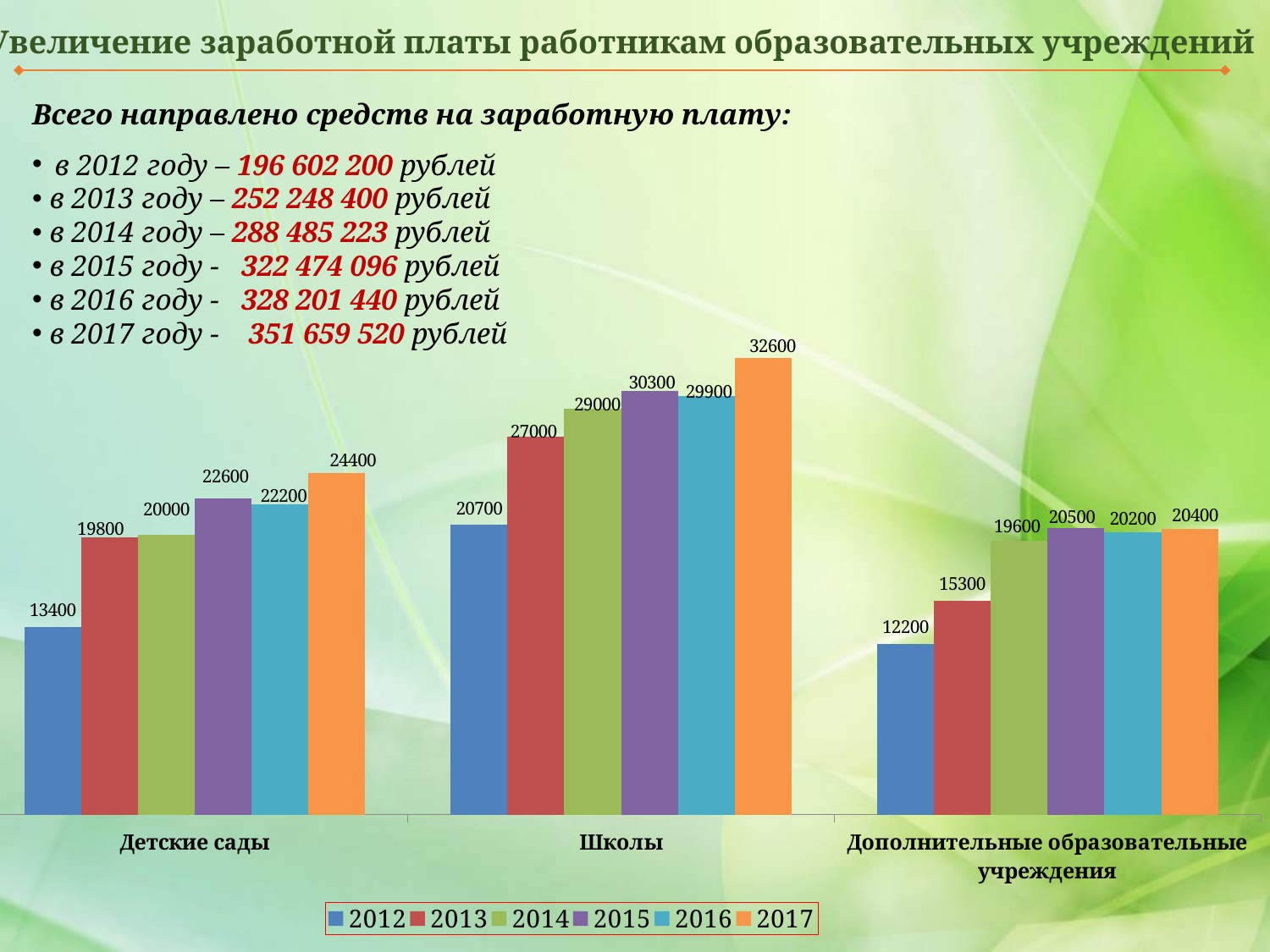
How many categories are shown on the x axis? 3 How many series does the legend list? 6 What is the value for Школы in 2017? 32600 What kind of chart is shown on the slide? bar chart What is the difference between the 2017 and 2012 values for Школы? 11900 What is the value for Детские сады in 2012? 13400 Which category has the lowest value in 2012? Дополнительные образовательные учреждения What is the value for Дополнительные образовательные учреждения in 2014? 19600 What is the difference between the 2015 and 2016 values for Детские сады? 400 Which year is shown in orange in the legend? 2017 Which is larger for Дополнительные образовательные учреждения: the 2013 value or the 2014 value? 2014 Which category has the highest value in 2015? Школы